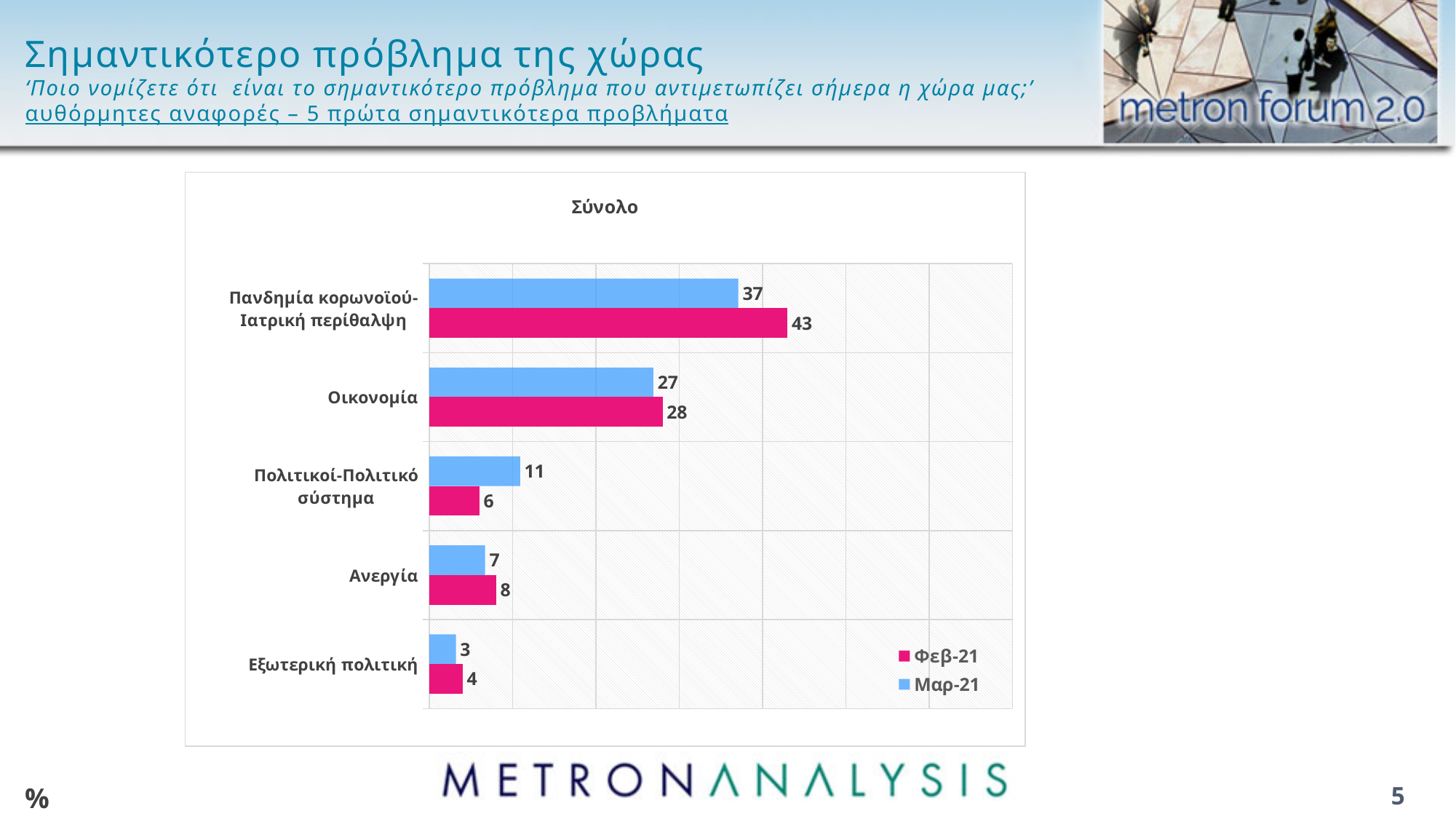
What is the value for Πολιτικοί-Πολιτικό σύστημα in the Μαρ-21 series? 11 What is the value for Εξωτερική πολιτική in the Φεβ-21 series? 4 How many series does the legend list? 2 Which category has the lowest value in the Φεβ-21 series? Εξωτερική πολιτική What is the value for Οικονομία in the Μαρ-21 series? 27 What is the difference between the Μαρ-21 and Φεβ-21 values for Πολιτικοί-Πολιτικό σύστημα? 5 What is the value for Πανδημία κορωνοϊού-Ιατρική περίθαλψη in the Φεβ-21 series? 43 For Ανεργία, which series has the larger value, Φεβ-21 or Μαρ-21? Φεβ-21 Which category has the highest value in the Μαρ-21 series? Πανδημία κορωνοϊού-Ιατρική περίθαλψη What type of chart is shown on the slide? Bar chart What is the difference between the Φεβ-21 and Μαρ-21 values for Πανδημία κορωνοϊού-Ιατρική περίθαλψη? 6 How many categories are shown in the chart? 5